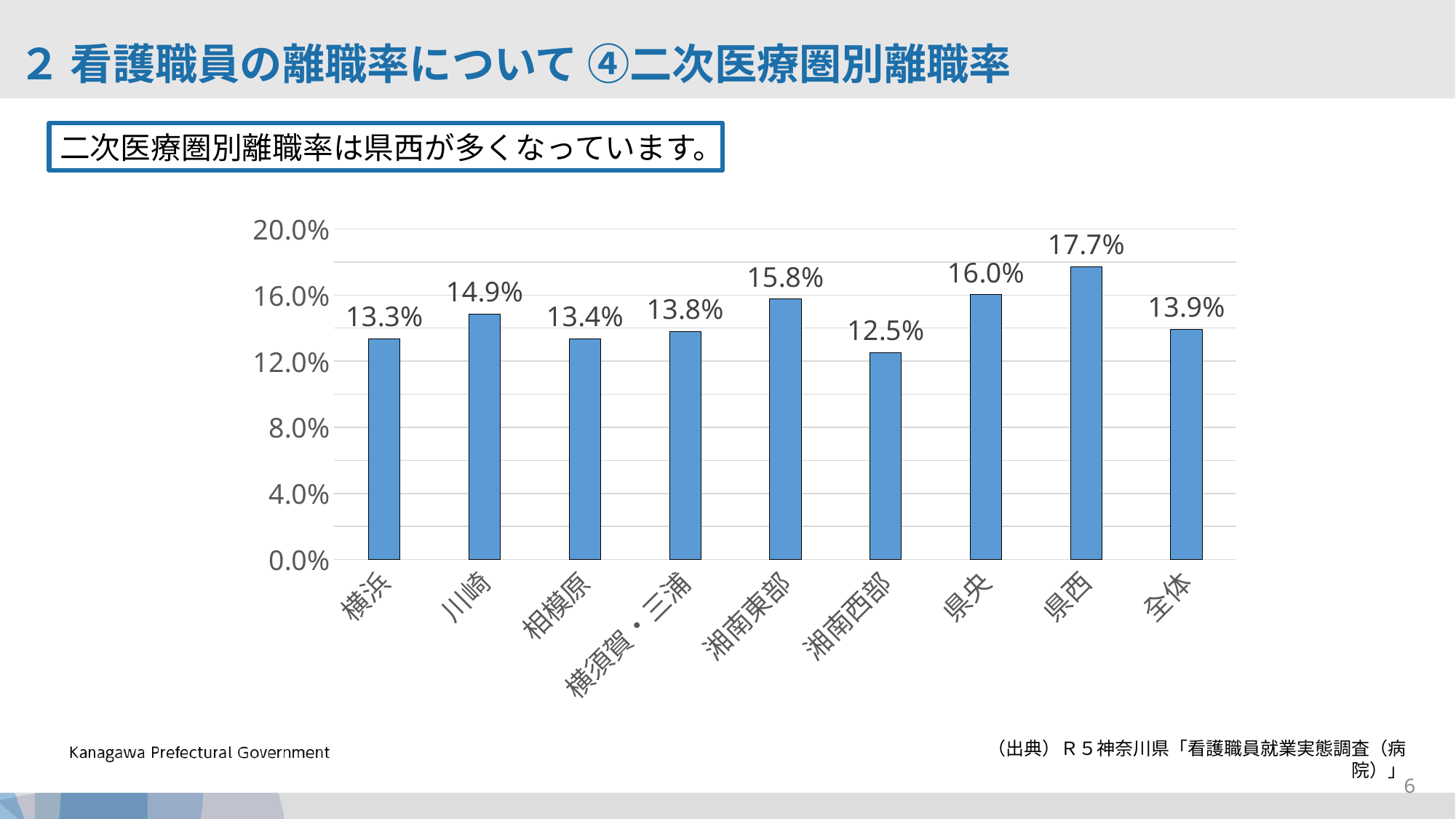
What is the value shown for 全体? 13.9% What is the turnover rate for 県西? 17.7% What is the difference between the turnover rates of 県西 and 湘南西部? 5.2% What kind of chart is shown on the slide? bar chart Is the value for 湘南東部 greater or less than 12.0%? greater What is the maximum value shown on the y axis? 20.0% What is the turnover rate for 横浜? 13.3% Which has a higher turnover rate, 川崎 or 相模原? 川崎 Which category has the lowest turnover rate? 湘南西部 Which category has the highest turnover rate? 県西 What is the difference between the turnover rates of 県央 and 全体? 2.1% How many categories are shown on the x axis? 9